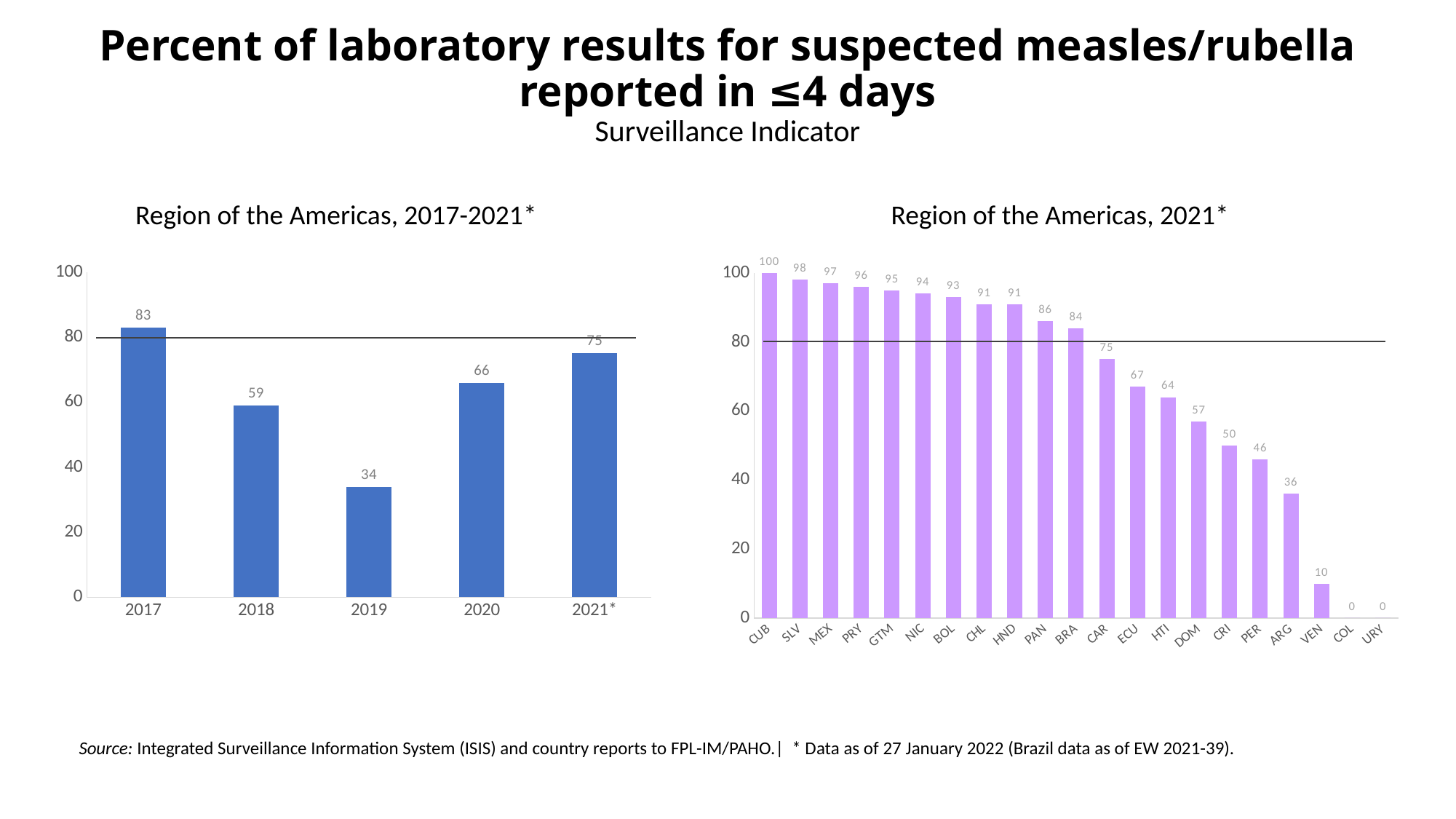
What kind of chart is the 'Region of the Americas, 2021*' chart? Bar chart In the 'Region of the Americas, 2021*' chart, which of ECU or DOM has the larger value? ECU In the 'Region of the Americas, 2017-2021*' chart, what is the difference between the values for 2017 and 2019? 49 In the 'Region of the Americas, 2017-2021*' chart, how many years are shown on the x axis? 5 In the 'Region of the Americas, 2017-2021*' chart, is the value for 2020 greater or less than 60? greater In the 'Region of the Americas, 2021*' chart, what is the value for BRA? 84 In the 'Region of the Americas, 2021*' chart, how many countries are shown on the x axis? 21 In the 'Region of the Americas, 2021*' chart, what is the value for VEN? 10 In the 'Region of the Americas, 2017-2021*' chart, which year has the highest value? 2017 In the 'Region of the Americas, 2021*' chart, which country has the highest value? CUB In the 'Region of the Americas, 2021*' chart, what is the difference between the values for CAR and ARG? 39 In the 'Region of the Americas, 2017-2021*' chart, what is the value for 2019? 34